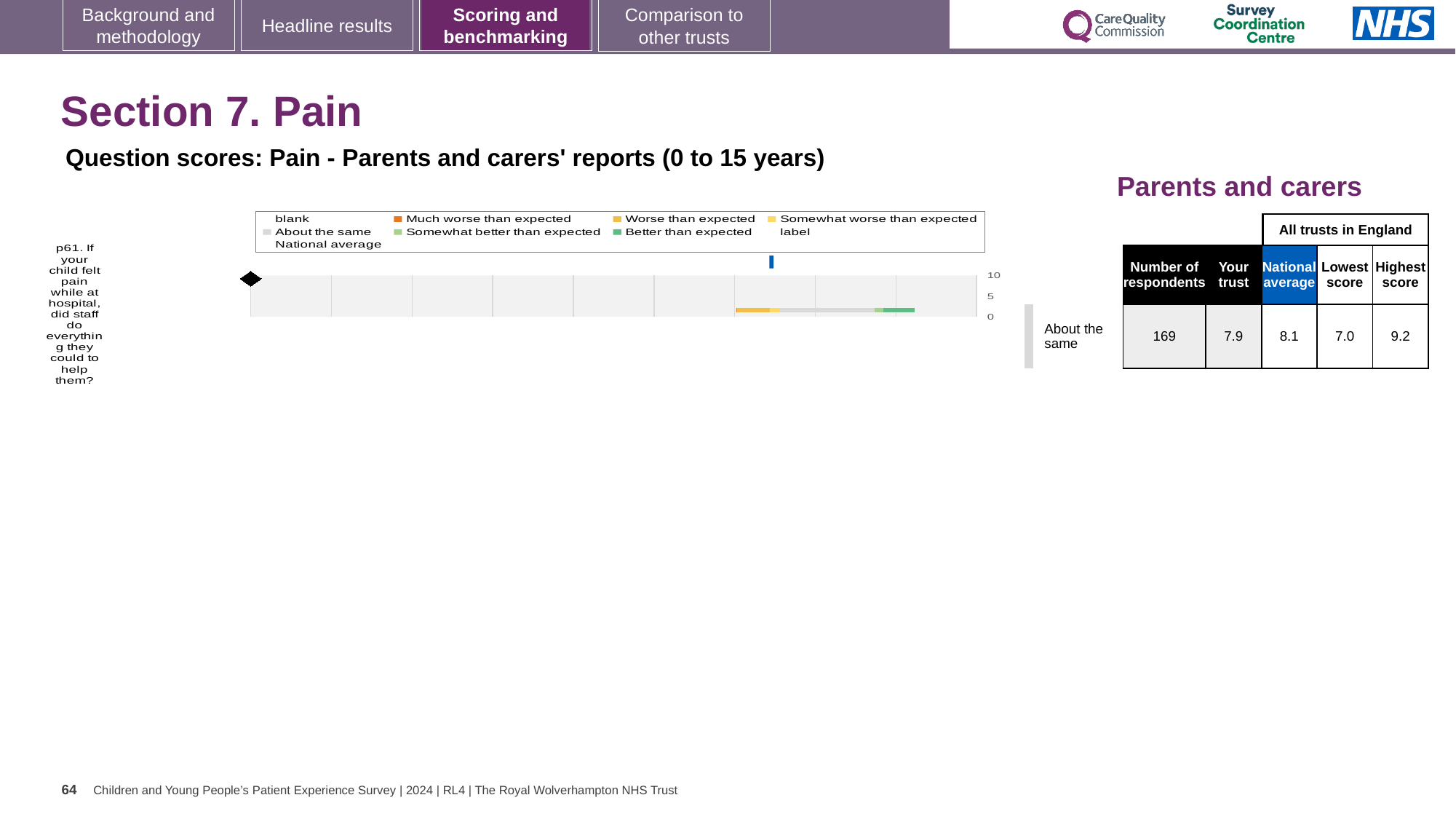
What benchmark category is the trust's result for question p61 placed in? About the same How many survey questions (categories) are plotted in the chart? 1 Which question is plotted in the chart? p61. If your child felt pain while at hospital, did staff do everything they could to help them? In the table, what is the 'Your trust' score for question p61? 7.9 In the table, what is the number of respondents for question p61? 169 In the table, what is the national average score for question p61? 8.1 What is the difference between the highest score and the lowest score for question p61? 2.2 In the table, what is the highest score among all trusts in England for question p61? 9.2 In the table, what is the lowest score among all trusts in England for question p61? 7.0 Which is larger for question p61: the 'Your trust' score or the national average? national average What kind of chart is shown on the slide? bar chart In the chart legend, which colour represents 'Much worse than expected'? orange